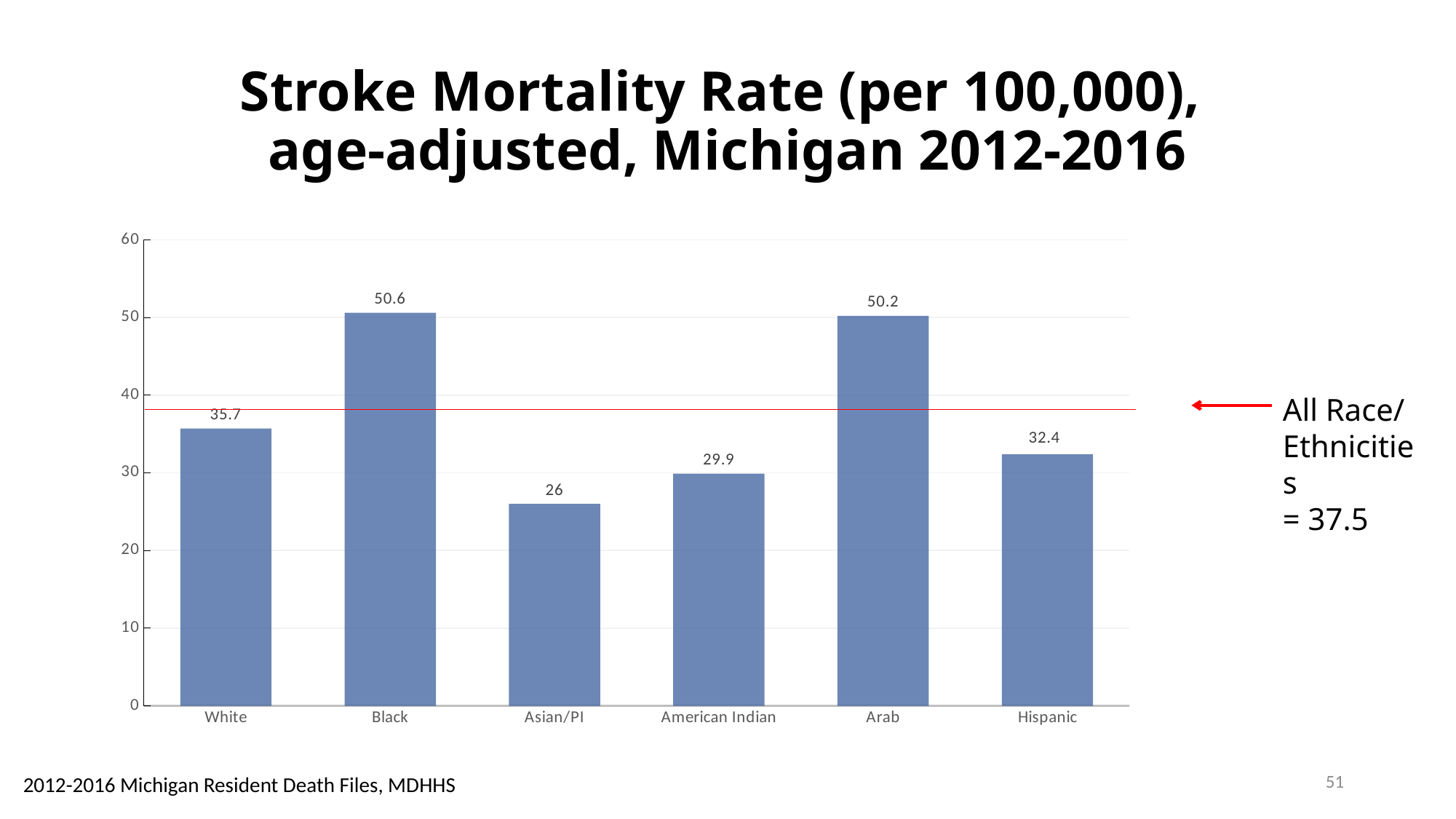
Which race/ethnicity has the highest stroke mortality rate? Black Which race/ethnicity has the lowest stroke mortality rate? Asian/PI What value does the red horizontal line represent? All Race/Ethnicities = 37.5 How many race/ethnicity categories are shown in the chart? 6 Which is larger, the stroke mortality rate for White residents or for Hispanic residents? White What is the difference between the stroke mortality rates for Black and Arab residents? 0.4 What is the stroke mortality rate for Hispanic residents? 32.4 Is the value for American Indian greater or less than 30? less What is the difference between the stroke mortality rates for White and American Indian residents? 5.8 What is the stroke mortality rate for Asian/PI residents? 26 What kind of chart is shown on the slide? bar chart What is the stroke mortality rate for Black residents? 50.6